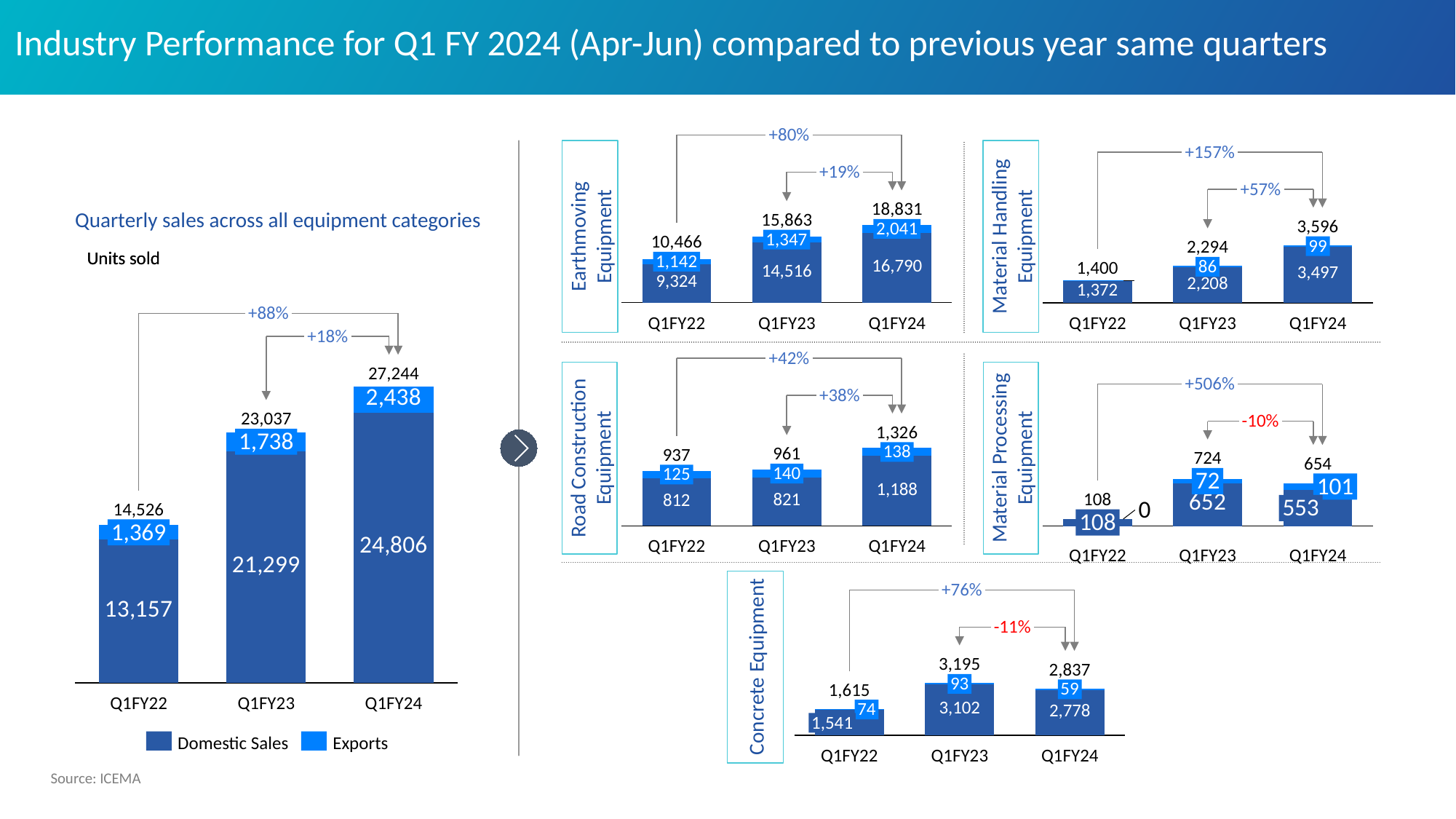
In the Concrete Equipment chart, what is the percentage change shown from Q1FY23 to Q1FY24? -11% In the 'Quarterly sales across all equipment categories' chart, what is the Domestic Sales value for Q1FY24? 24,806 In the Road Construction Equipment chart, what is the total for Q1FY24? 1,326 In the Material Processing Equipment chart, which quarter has the lowest total? Q1FY22 In the Material Handling Equipment chart, what is the Domestic Sales value for Q1FY24? 3,497 In the 'Quarterly sales across all equipment categories' chart, what is the total units sold for Q1FY23? 23,037 In the Earthmoving Equipment chart, what is the Exports value for Q1FY23? 1,347 In the 'Quarterly sales across all equipment categories' chart, what is the difference between Exports in Q1FY24 and Exports in Q1FY22? 1,069 In the Earthmoving Equipment chart, which quarter has the highest total? Q1FY24 How many series does the legend of the 'Quarterly sales across all equipment categories' chart list? 2 What kind of chart is the 'Quarterly sales across all equipment categories' chart? Stacked bar chart In the Concrete Equipment chart, is the Q1FY23 total larger or smaller than the Q1FY24 total? Larger